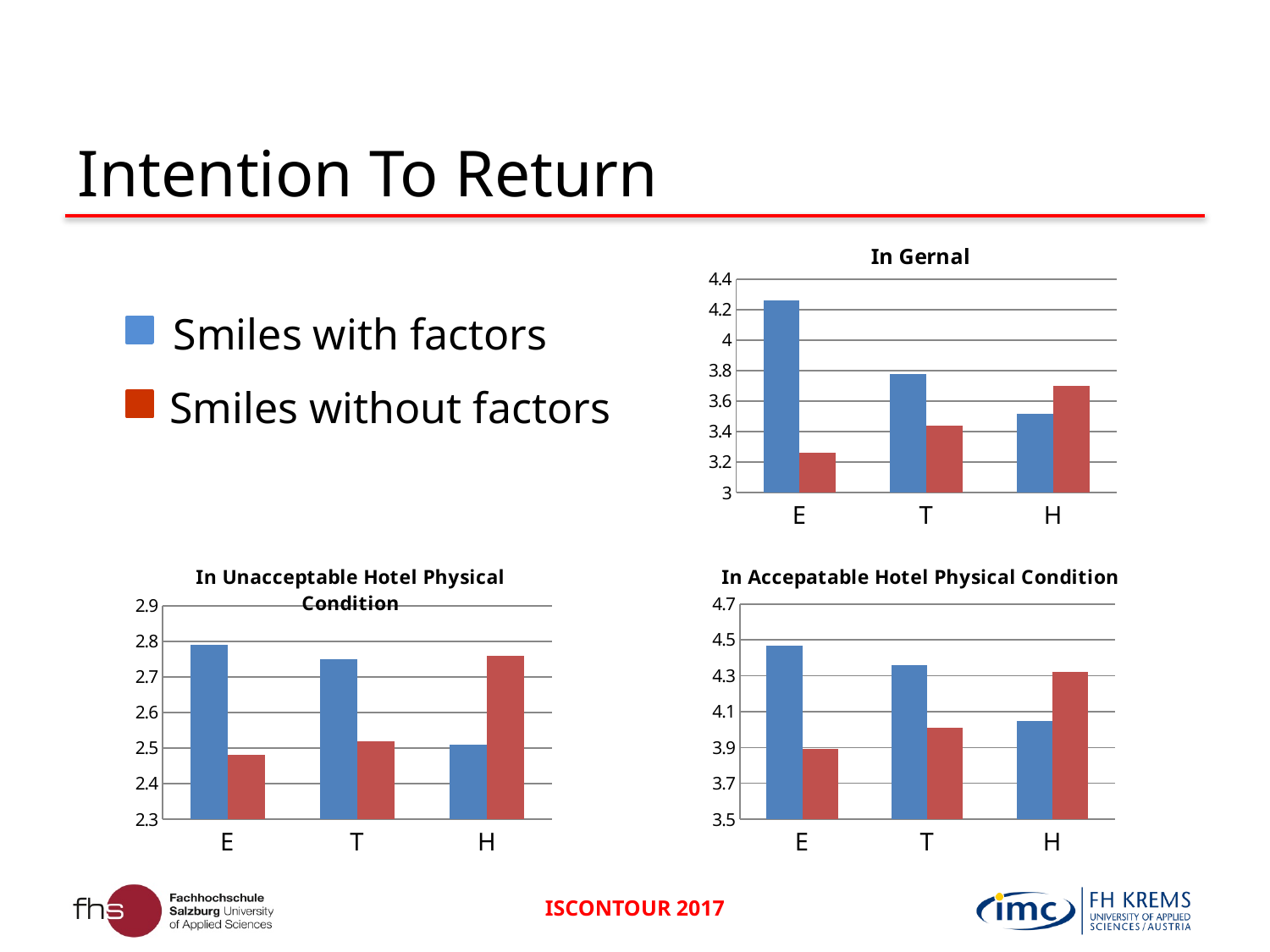
In the 'In Gernal' chart, is the 'Smiles without factors' value for E greater or less than 3.4? less In the 'In Gernal' chart, which category has the highest 'Smiles with factors' (blue) bar? E In the 'In Accepatable Hotel Physical Condition' chart, do the 'Smiles without factors' bars rise or fall from E to H? rise What kind of chart is the 'In Accepatable Hotel Physical Condition' chart? bar chart In the 'In Unacceptable Hotel Physical Condition' chart, which category has the lowest 'Smiles with factors' (blue) bar? H How many categories are shown on the x axis of the 'In Gernal' chart? 3 In the 'In Gernal' chart, for category H, which is larger: 'Smiles with factors' or 'Smiles without factors'? Smiles without factors In the 'In Gernal' chart, do the 'Smiles with factors' bars rise or fall from E to H? fall In the 'In Unacceptable Hotel Physical Condition' chart, is the 'Smiles without factors' value for H greater or less than 2.7? greater In the 'In Accepatable Hotel Physical Condition' chart, is the 'Smiles with factors' value for E greater or less than 4.3? greater In the 'In Unacceptable Hotel Physical Condition' chart, for category E, which is larger: 'Smiles with factors' or 'Smiles without factors'? Smiles with factors